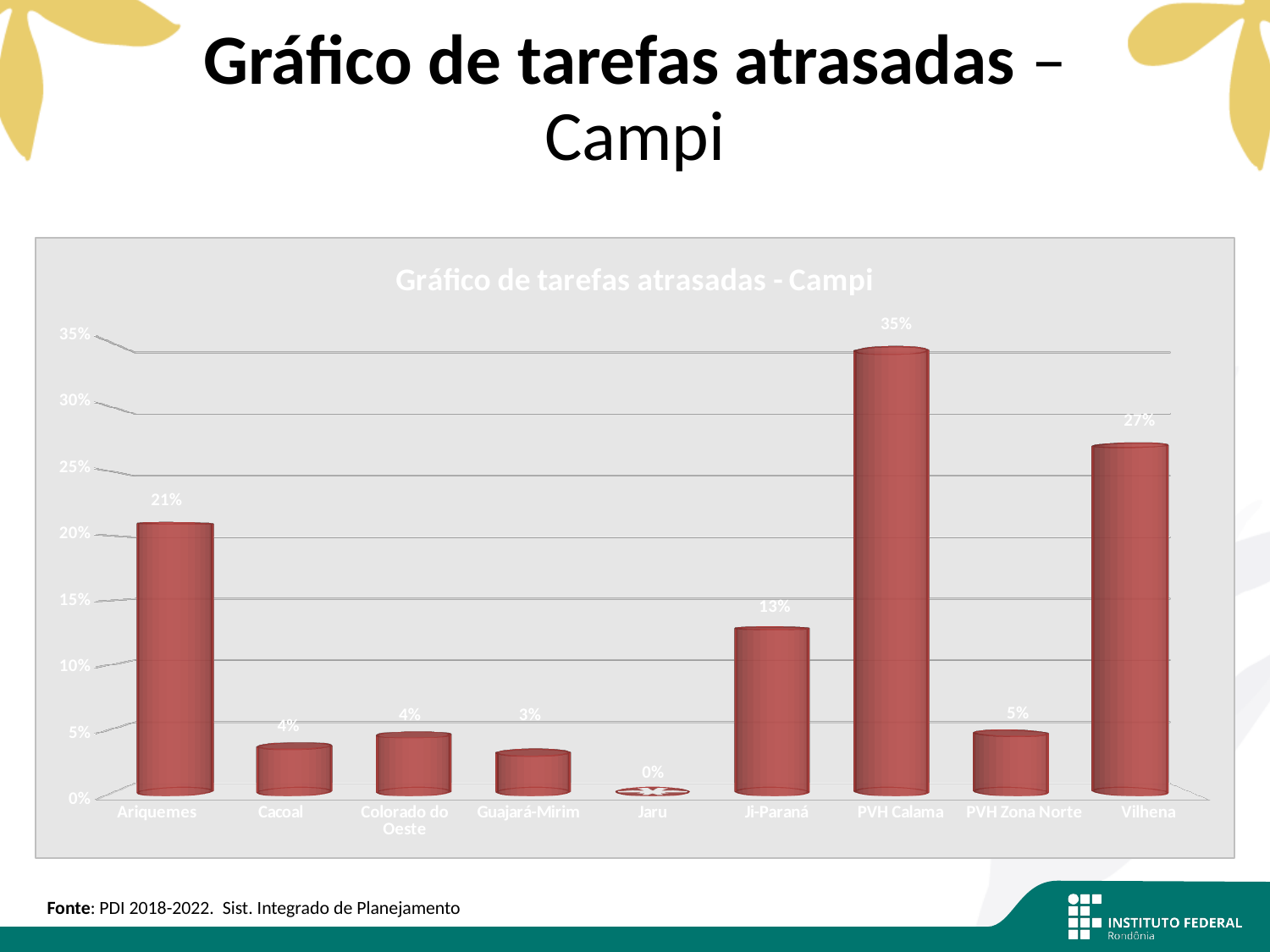
Is the value for Ji-Paraná greater or less than 10%? greater What is the value for Ariquemes? 21% What is the value for Ji-Paraná? 13% What is the value for Jaru? 0% What is the value for PVH Calama? 35% What is the title of the chart? Gráfico de tarefas atrasadas - Campi Which campus has the highest value? PVH Calama Which is larger, the value for Ariquemes or the value for Vilhena? Vilhena Which campus has the lowest value? Jaru How many campuses are shown on the x axis? 9 What is the difference between the values for PVH Calama and Vilhena? 8% What kind of chart is shown? bar chart